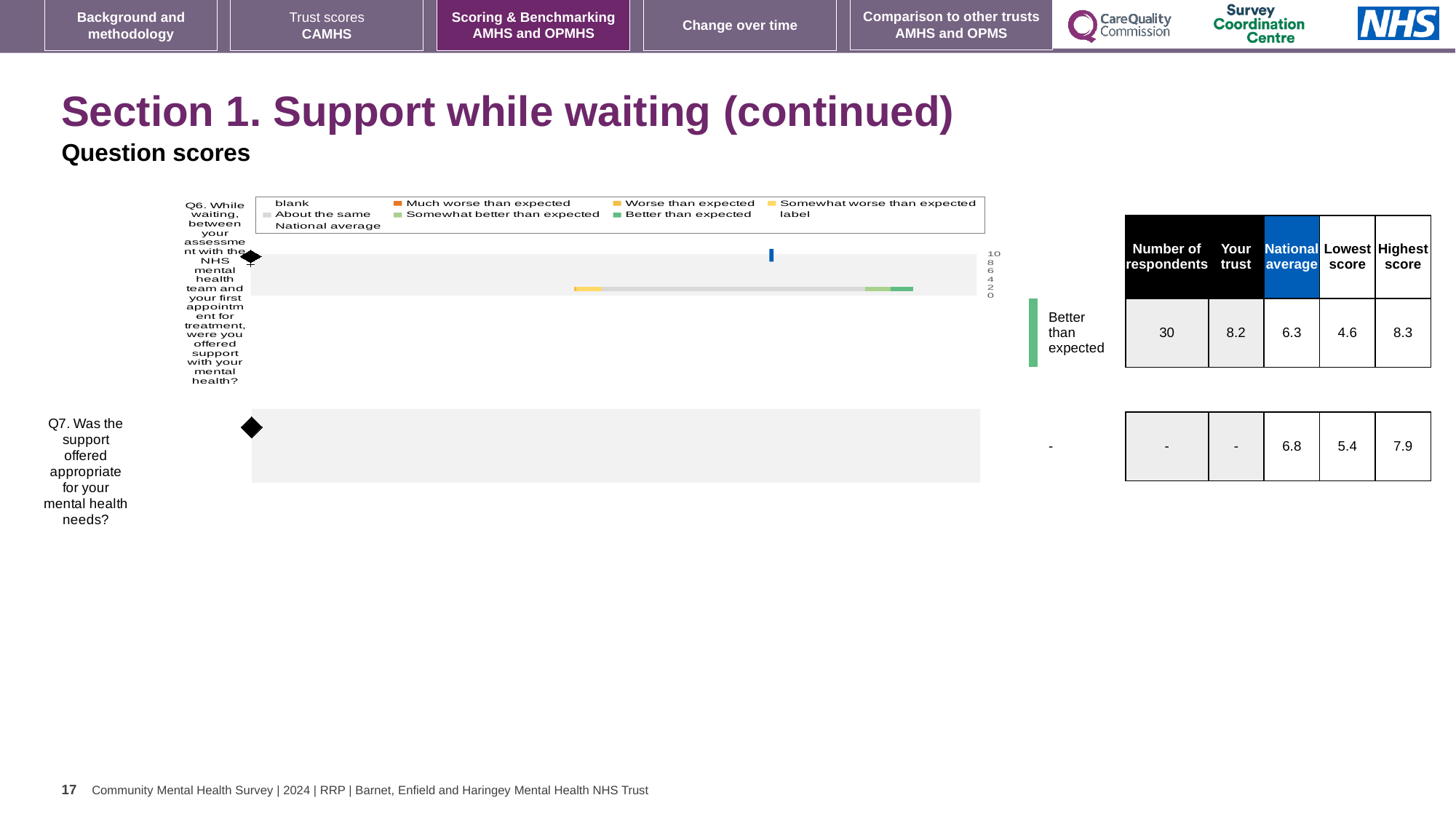
What is the national average score for Q6 shown next to the chart? 6.3 What colour is the legend entry for 'Much worse than expected' in the chart? orange What is the difference between the 'Your trust' score and the national average for Q6? 1.9 What is the national average score shown for Q7? 6.8 What kind of chart is used to show the question scores on this slide? bar chart What is the highest score shown for Q6? 8.3 What benchmark category label is shown beside the Q6 bar? Better than expected For Q6, which is larger: the 'Your trust' score or the national average? Your trust How many respondents are shown for Q6? 30 What colour is the legend entry for 'Better than expected' in the chart? green How many questions (rows) are plotted in the chart on this slide? 2 What is the 'Your trust' score for Q6 shown next to the chart? 8.2